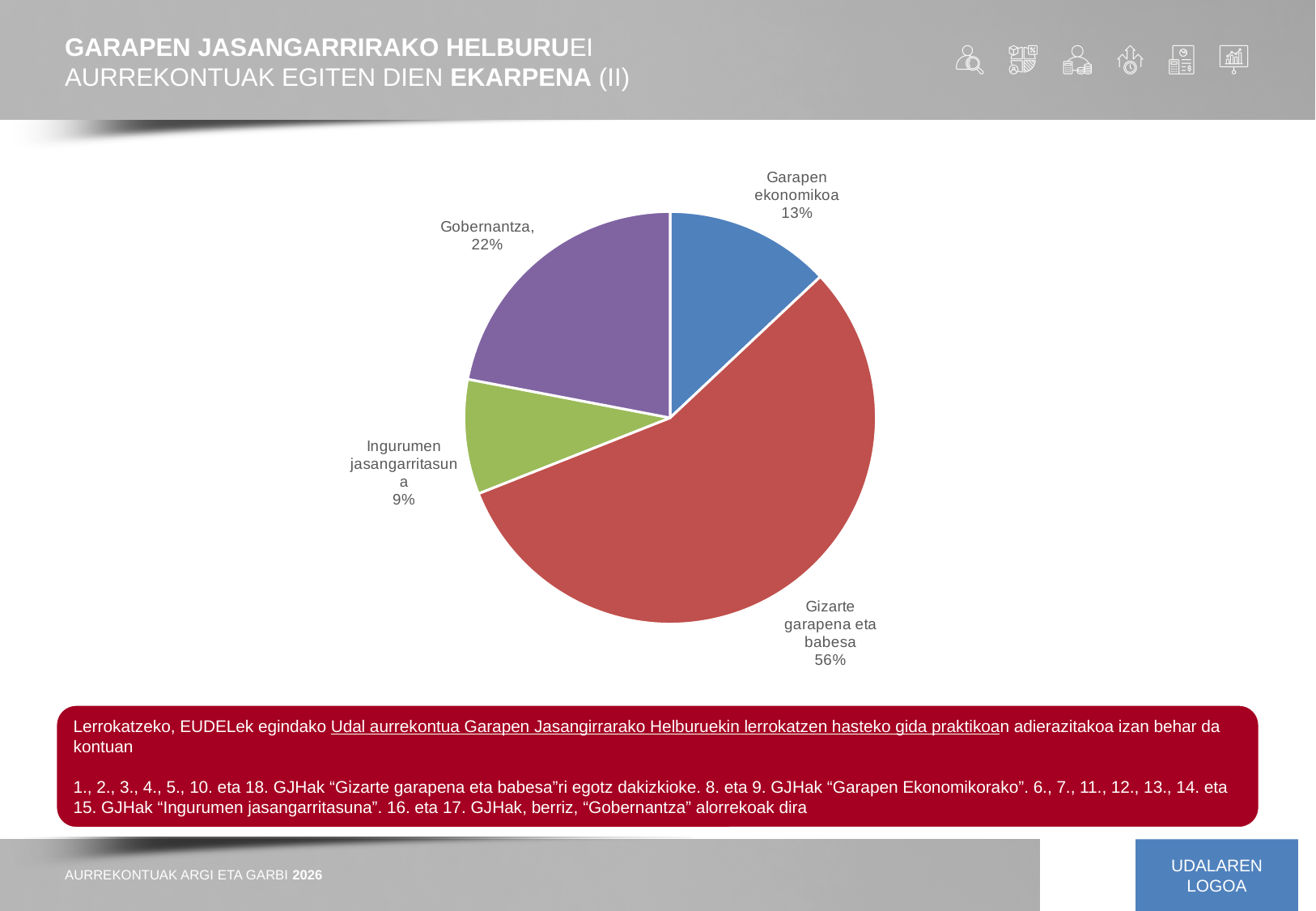
Which category has the smallest slice of the pie? Ingurumen jasangarritasuna What kind of chart is shown on the slide? pie chart What colour is the slice for Gizarte garapena eta babesa? red Which category has the largest slice of the pie? Gizarte garapena eta babesa What is the difference in percentage points between Gizarte garapena eta babesa and Gobernantza? 34 What is the difference in percentage points between Garapen ekonomikoa and Ingurumen jasangarritasuna? 4 What share of the pie does Gizarte garapena eta babesa have? 56% What share of the pie does Garapen ekonomikoa have? 13% How many slices does the pie chart have? 4 What share of the pie does Ingurumen jasangarritasuna have? 9% Which is larger, the share for Gobernantza or the share for Garapen ekonomikoa? Gobernantza